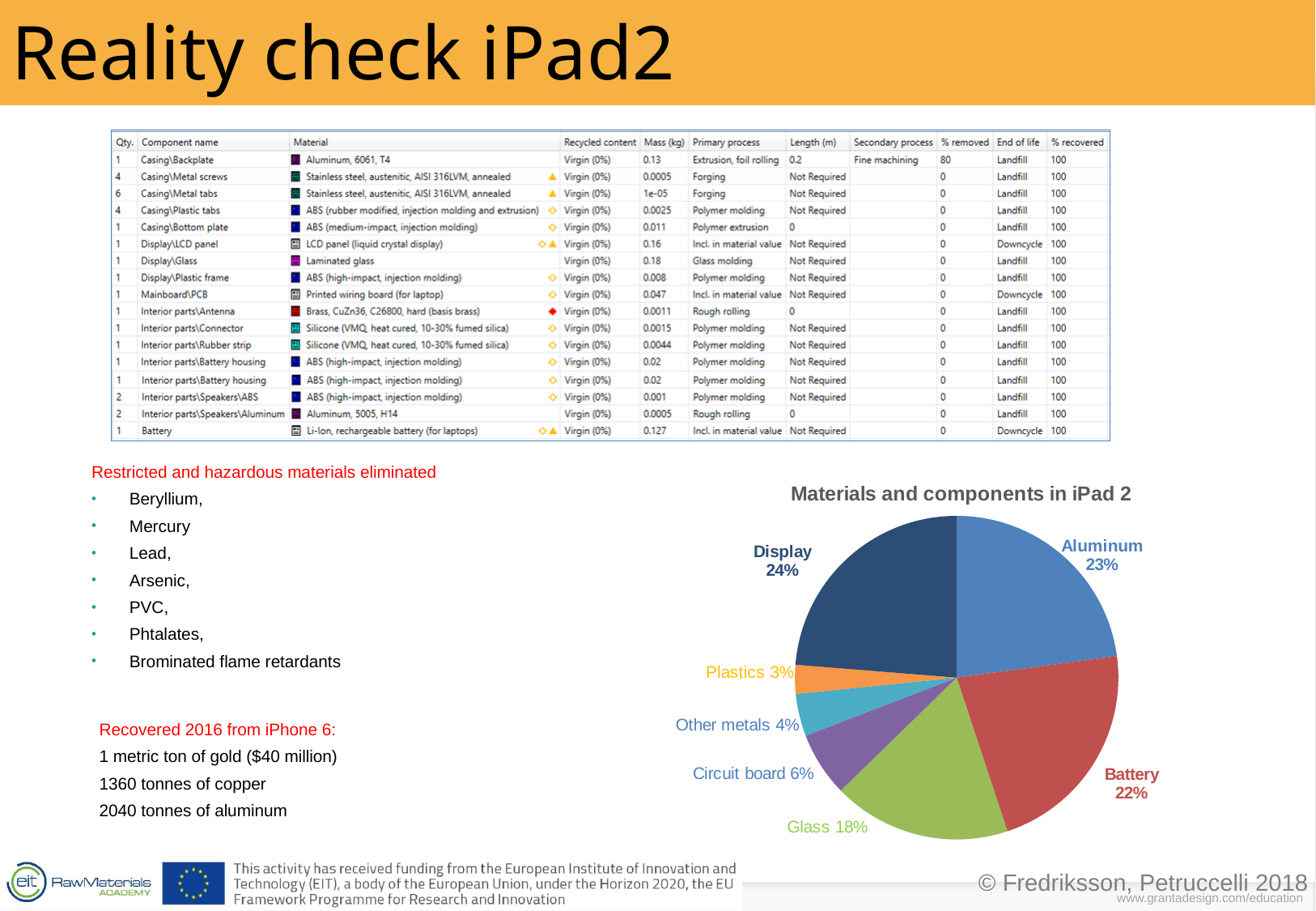
In the pie chart, what share does Display have? 24% What type of chart is "Materials and components in iPad 2"? pie chart In the pie chart, what share does Aluminum have? 23% In the pie chart, what share does Circuit board have? 6% What is the difference in percentage points between Glass and Circuit board in the pie chart? 12 How many slices does the pie chart have? 7 In the pie chart, what share does Glass have? 18% In the pie chart, what share does Plastics have? 3% What is the title of the pie chart? Materials and components in iPad 2 Which slice of the pie chart is the largest? Display Which slice of the pie chart is the smallest? Plastics In the pie chart, what share does Battery have? 22%